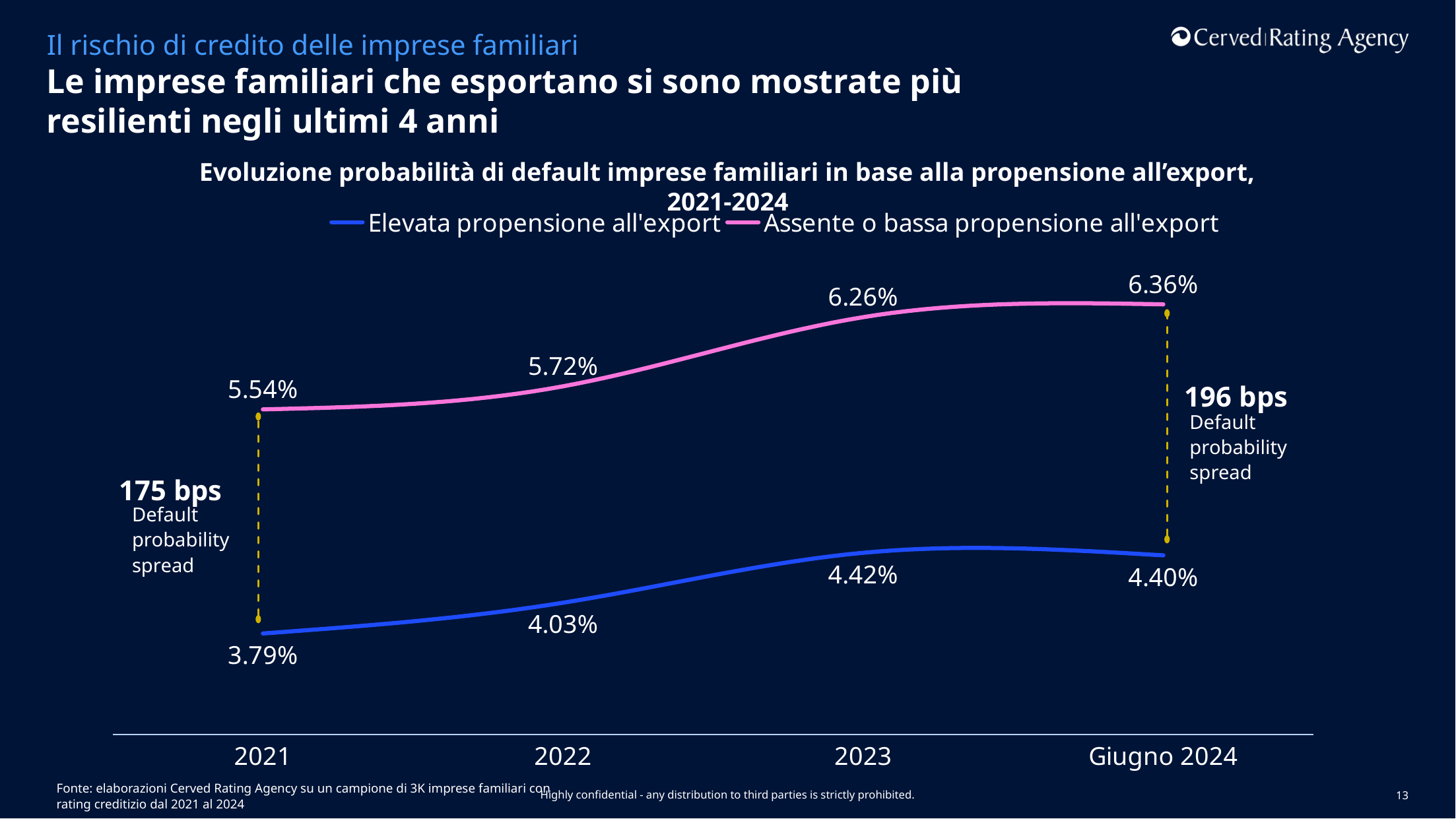
What is the value for 'Assente o bassa propensione all'export' in 2022? 5.72% In which year does the 'Elevata propensione all'export' series have its lowest value? 2021 What is the value for 'Elevata propensione all'export' in 2023? 4.42% What kind of chart is shown? Line chart Which series has the higher value in 2023? Assente o bassa propensione all'export What default probability spread is annotated for Giugno 2024? 196 bps What is the value for 'Elevata propensione all'export' in 2021? 3.79% What is the value for 'Assente o bassa propensione all'export' in Giugno 2024? 6.36% In which year does the 'Assente o bassa propensione all'export' series reach its highest value? Giugno 2024 How many time points are shown on the x axis? 4 What is the difference between the two series in 2022? 1.69% How many series does the legend list? 2